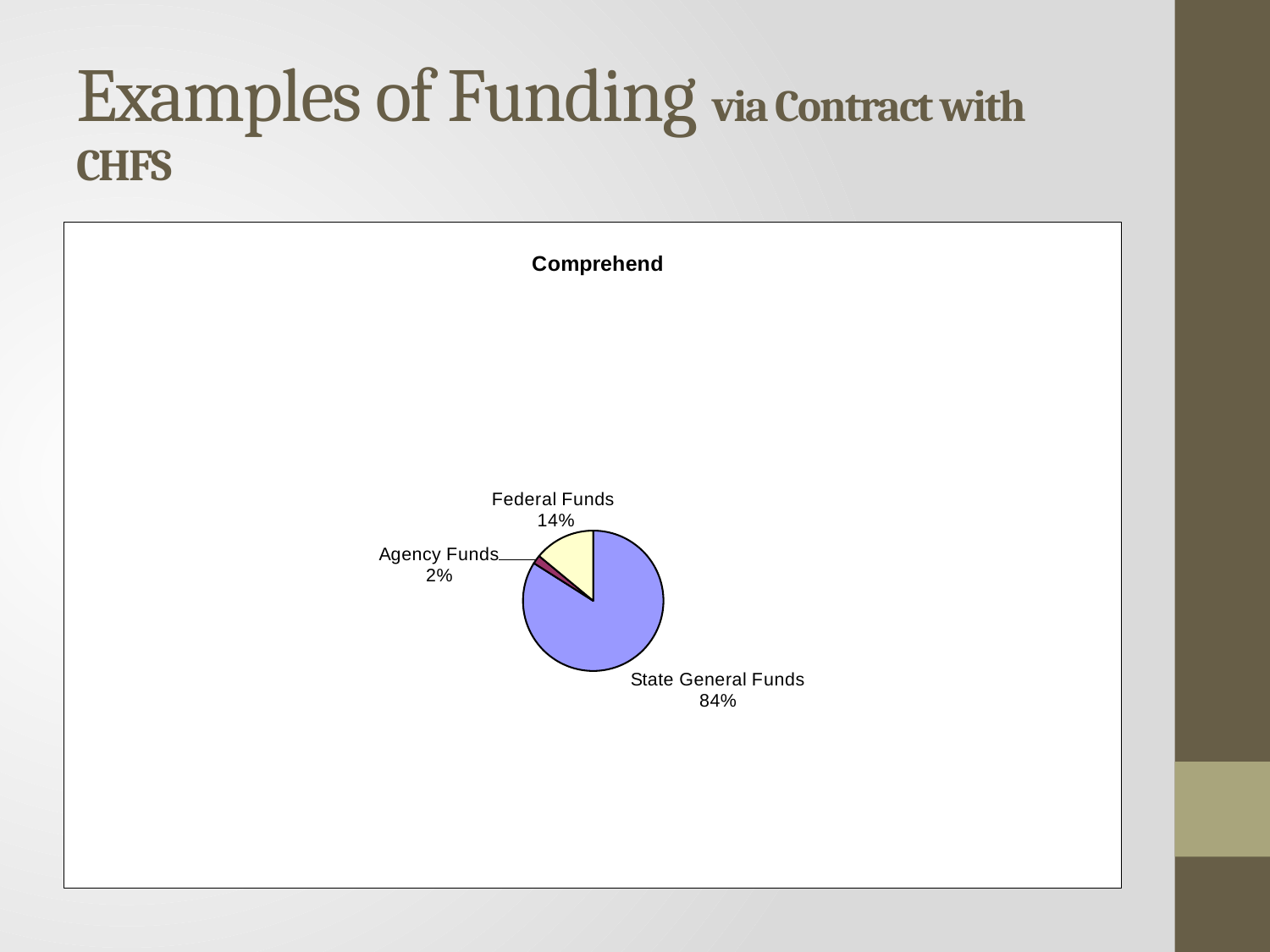
How many slices does the pie chart have? 3 What is the title of the chart? Comprehend What is the difference in percentage points between Federal Funds and Agency Funds? 12 What is the difference in percentage points between State General Funds and Federal Funds? 70 Which funding source has the largest share? State General Funds Which funding source has the smallest share? Agency Funds What share of the pie is State General Funds? 84% What kind of chart is shown on the slide? pie chart What share of the pie is Federal Funds? 14% What share of the pie is Agency Funds? 2% What colour is the State General Funds slice? blue Which is larger, Federal Funds or Agency Funds? Federal Funds